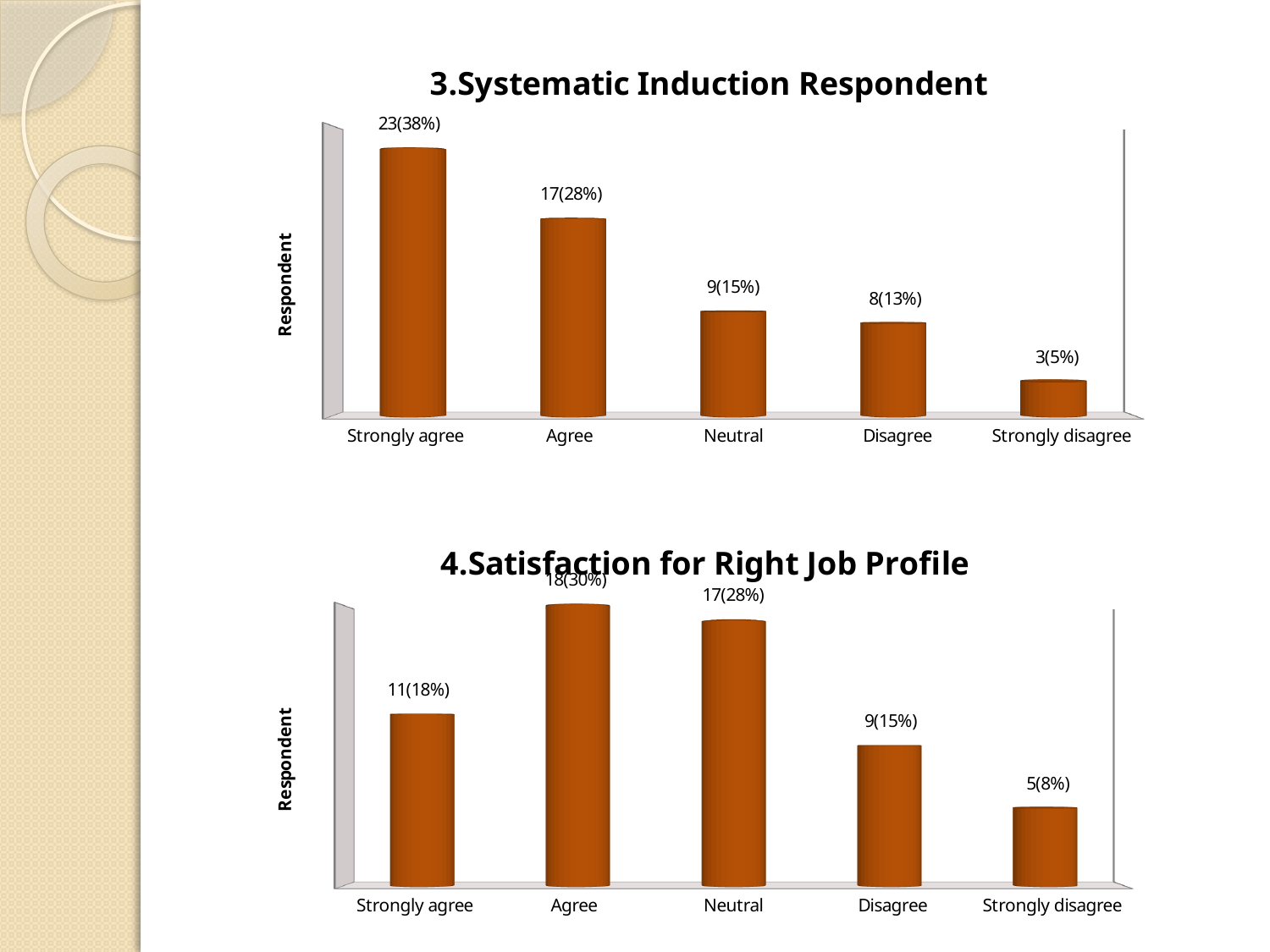
In the chart titled "3.Systematic Induction Respondent", what is the value for Strongly agree? 23(38%) What kind of chart is the top chart on the slide? bar chart In the chart titled "3.Systematic Induction Respondent", how many more respondents chose Strongly agree than Agree? 6 In the chart titled "4.Satisfaction for Right Job Profile", which category has the highest value? Agree In the chart titled "3.Systematic Induction Respondent", what is the value for Neutral? 9(15%) In the chart titled "3.Systematic Induction Respondent", do the values rise or fall from left to right along the x axis? fall In the chart titled "4.Satisfaction for Right Job Profile", what is the value for Strongly disagree? 5(8%) In the chart titled "3.Systematic Induction Respondent", which category has the lowest value? Strongly disagree In the chart titled "4.Satisfaction for Right Job Profile", which is larger, the value for Neutral or the value for Disagree? Neutral How many categories are shown on the x axis of the chart titled "4.Satisfaction for Right Job Profile"? 5 In the chart titled "4.Satisfaction for Right Job Profile", what is the value for Strongly agree? 11(18%) In the chart titled "3.Systematic Induction Respondent", which category has the highest value? Strongly agree